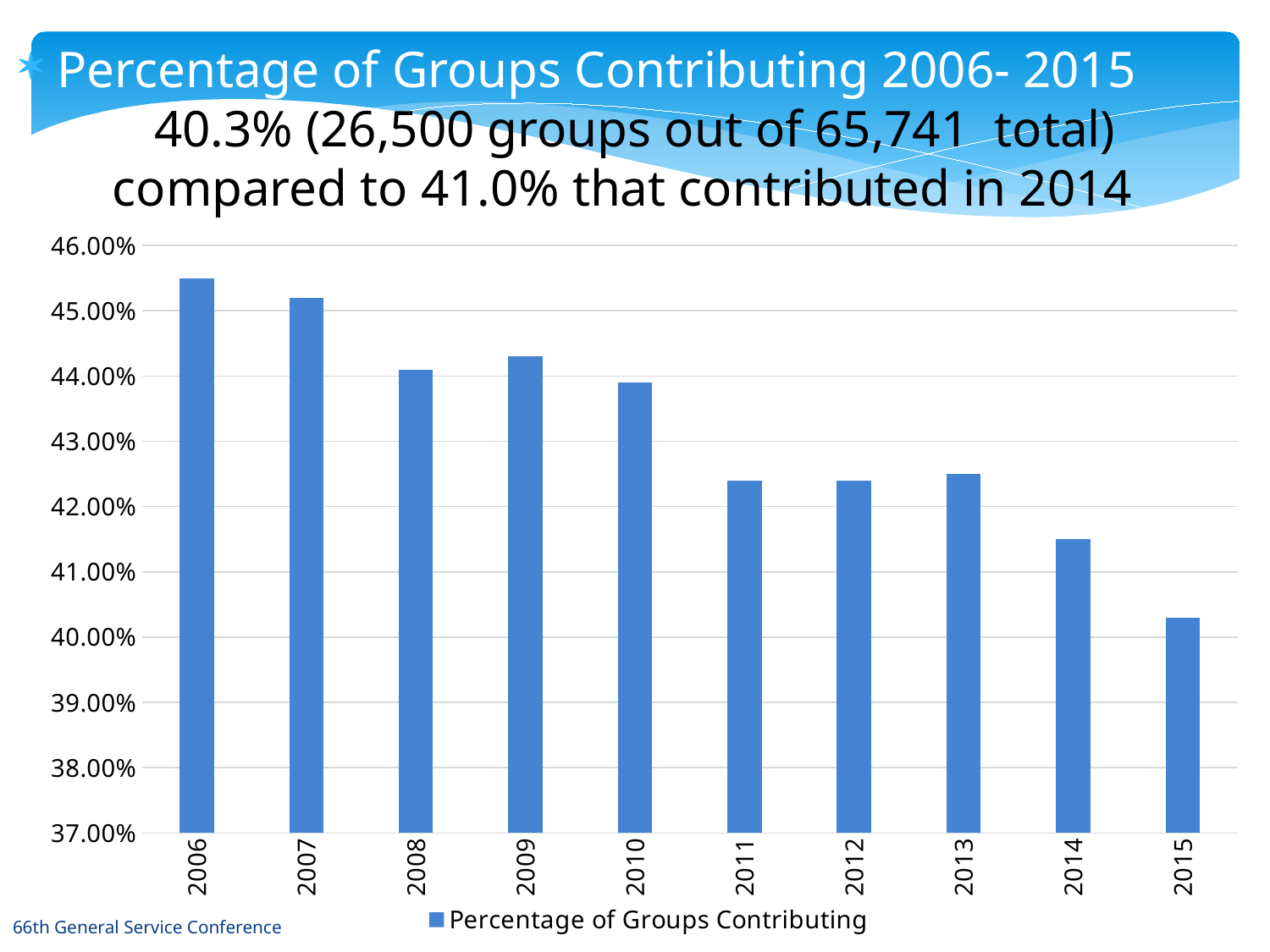
Which year has the lowest percentage of groups contributing? 2015 Is the value for 2006 greater or less than 45.00%? greater What is the name of the series shown in the legend? Percentage of Groups Contributing How many years are plotted on the x axis? 10 How many series does the legend list? 1 Which year has the larger value, 2013 or 2014? 2013 Which year has the larger value, 2006 or 2010? 2006 Do the values generally rise or fall from 2006 to 2015? fall Which year has the highest percentage of groups contributing? 2006 Is the value for 2011 greater or less than 43.00%? less Is the value for 2014 greater or less than 42.00%? less What kind of chart is shown on the slide? bar chart